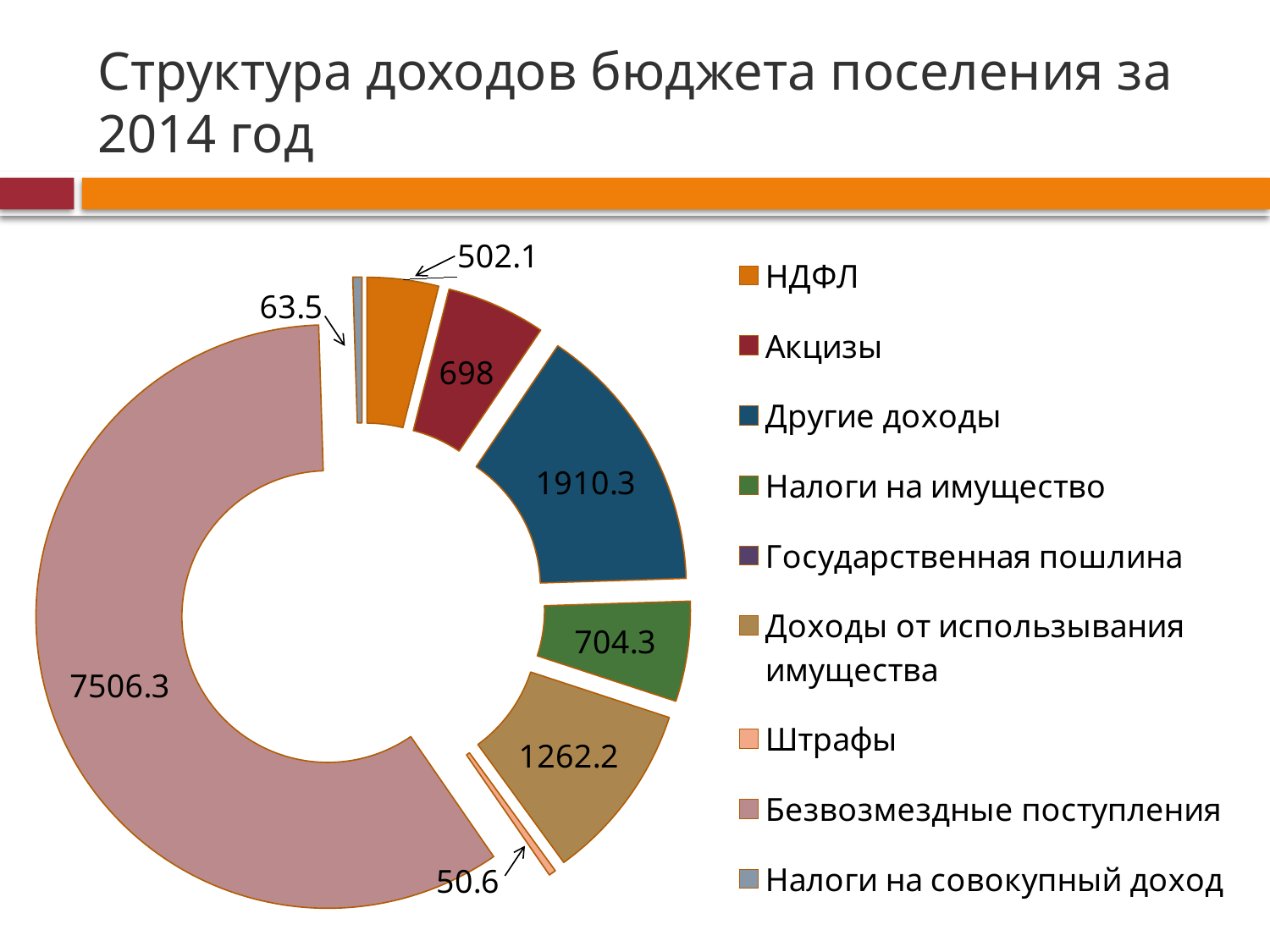
Which is larger, Акцизы or Налоги на имущество? Налоги на имущество What is the value for Доходы от использывания имущества? 1262.2 What is the value for Налоги на совокупный доход? 63.5 What is the value for Штрафы? 50.6 What is the difference between Налоги на имущество and Акцизы? 6.3 What is the value for Безвозмездные поступления? 7506.3 How many categories does the legend list? 9 Which category has the largest value? Безвозмездные поступления What is the value for Другие доходы? 1910.3 What kind of chart is shown on the slide? Doughnut (pie) chart What is the value for НДФЛ? 502.1 What is the difference between Другие доходы and Доходы от использывания имущества? 648.1